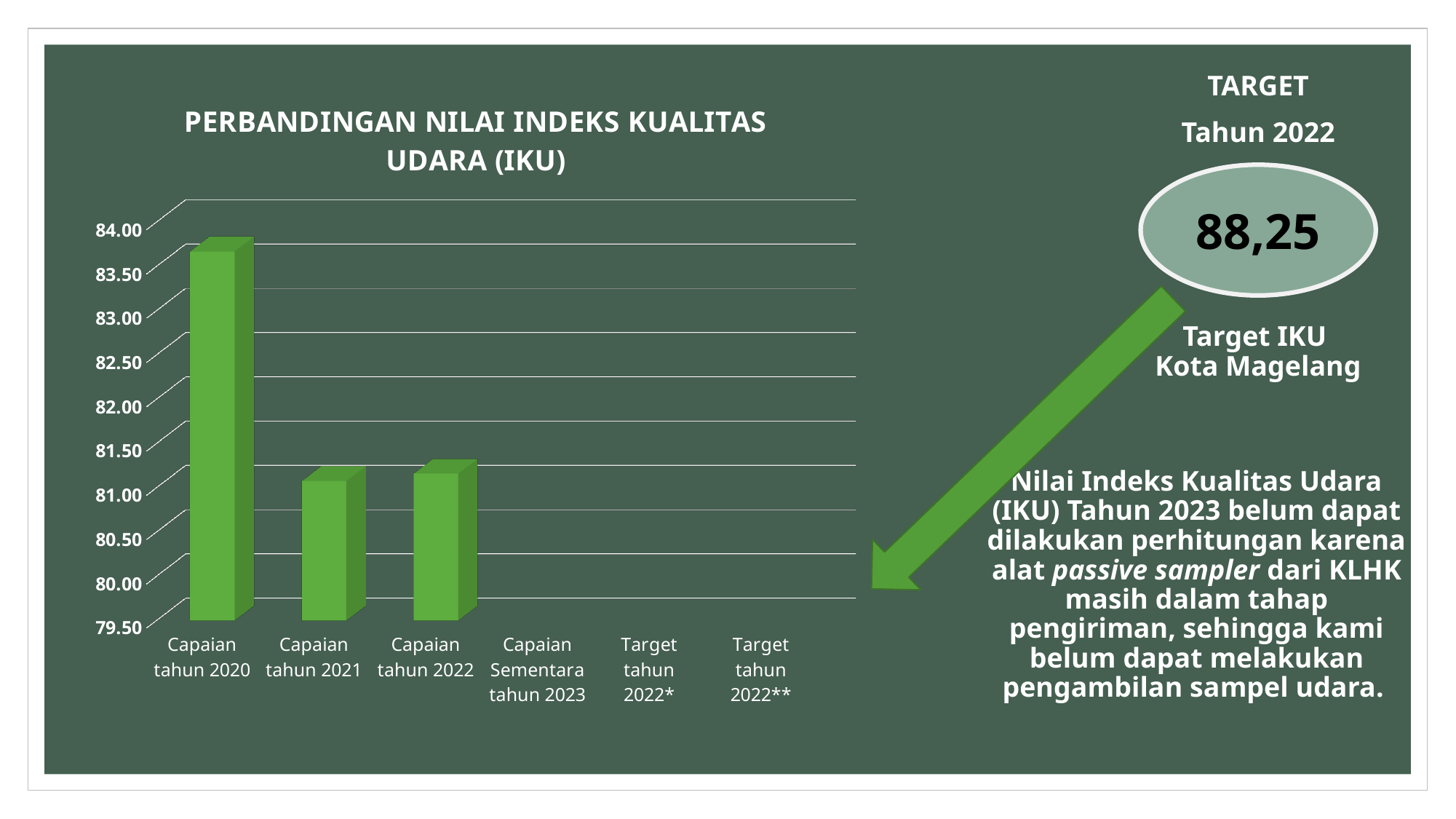
What is the title of the chart? PERBANDINGAN NILAI INDEKS KUALITAS UDARA (IKU) Is the value for Capaian tahun 2022 greater or less than 82.00? less How many categories in the chart actually have a bar plotted? 3 How many categories are listed along the x axis of the chart? 6 What is the lowest value shown on the chart's vertical axis? 79.50 Which category has the highest bar in the chart? Capaian tahun 2020 Which is larger, the value for Capaian tahun 2020 or the value for Capaian tahun 2022? Capaian tahun 2020 What kind of chart is shown on the slide? bar chart Is the value for Capaian tahun 2020 greater or less than 83.00? greater Is the value for Capaian tahun 2021 greater or less than 82.00? less Does the value fall or rise from Capaian tahun 2020 to Capaian tahun 2021? fall